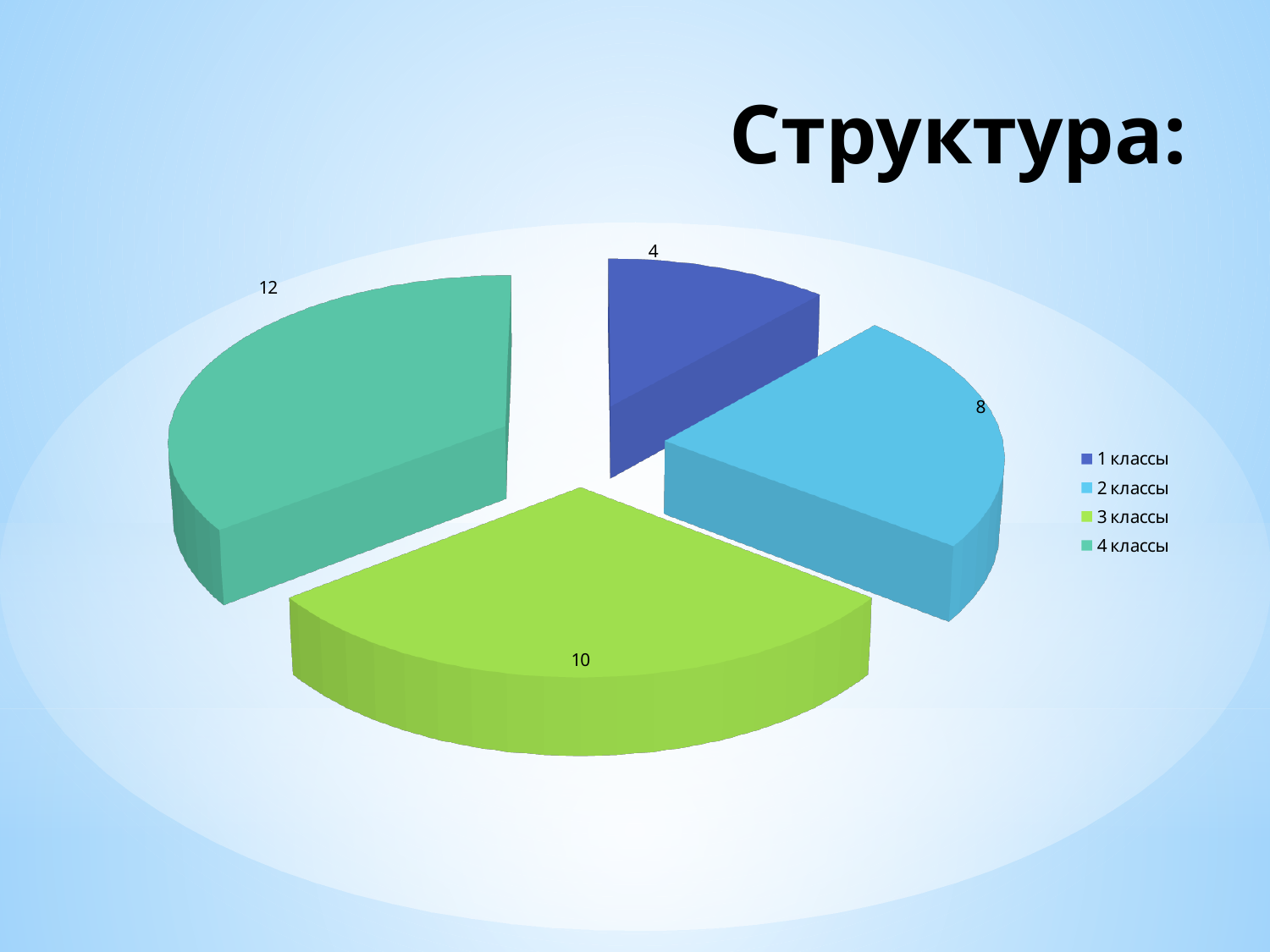
Which category has the smallest slice? 1 классы What kind of chart is shown on the slide? Pie chart What is the value for 1 классы? 4 What is the title of the slide? Структура: Which is larger, the value for 2 классы or the value for 3 классы? 3 классы Which category has the largest slice? 4 классы What is the value for 2 классы? 8 What is the value for 4 классы? 12 What is the difference between the values for 4 классы and 1 классы? 8 How many slices does the pie chart have? 4 What is the total of all the slice values? 34 What is the value for 3 классы? 10